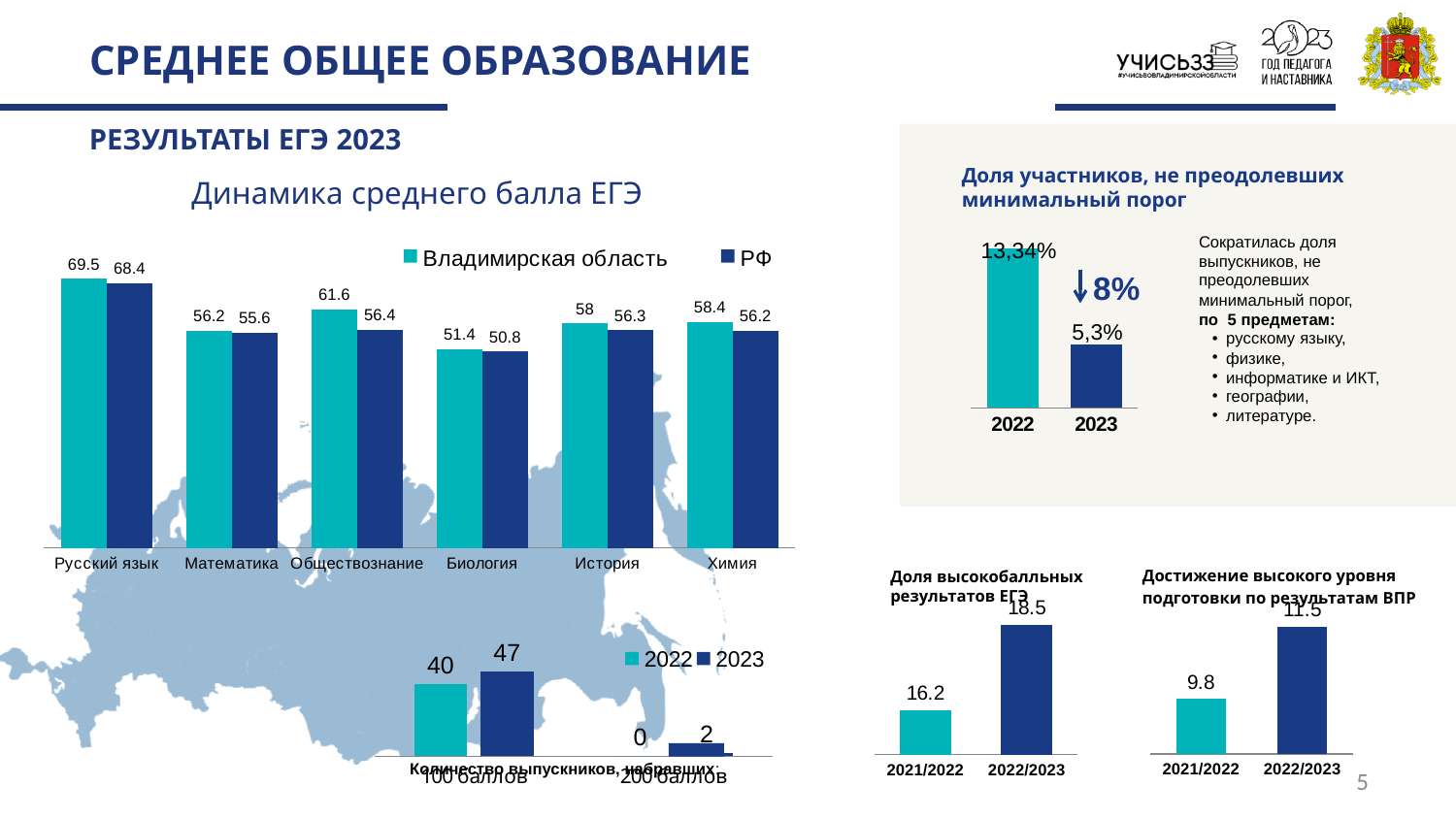
In the chart 'Динамика среднего балла ЕГЭ', which subject has the lowest value for Владимирская область? Биология In the chart 'Динамика среднего балла ЕГЭ', how many subjects are shown on the x axis? 6 In the chart 'Динамика среднего балла ЕГЭ', what is the value for Владимирская область in Русский язык? 69.5 What kind of chart is 'Достижение высокого уровня подготовки по результатам ВПР'? Bar chart In the chart 'Доля участников, не преодолевших минимальный порог', what is the value for 2022? 13,34% In the chart 'Динамика среднего балла ЕГЭ', how many series does the legend list? 2 In the chart 'Динамика среднего балла ЕГЭ', what is the value for РФ in Обществознание? 56.4 In the chart 'Динамика среднего балла ЕГЭ', what is the difference between Владимирская область and РФ in Обществознание? 5.2 In the chart 'Доля высокобалльных результатов ЕГЭ', what is the difference between 2022/2023 and 2021/2022? 2.3 In the chart 'Количество выпускников, набравших', how many graduates scored 100 баллов in 2023? 47 In the chart 'Динамика среднего балла ЕГЭ', which is larger in История: Владимирская область or РФ? Владимирская область In the chart 'Доля участников, не преодолевших минимальный порог', what is the value for 2023? 5,3%